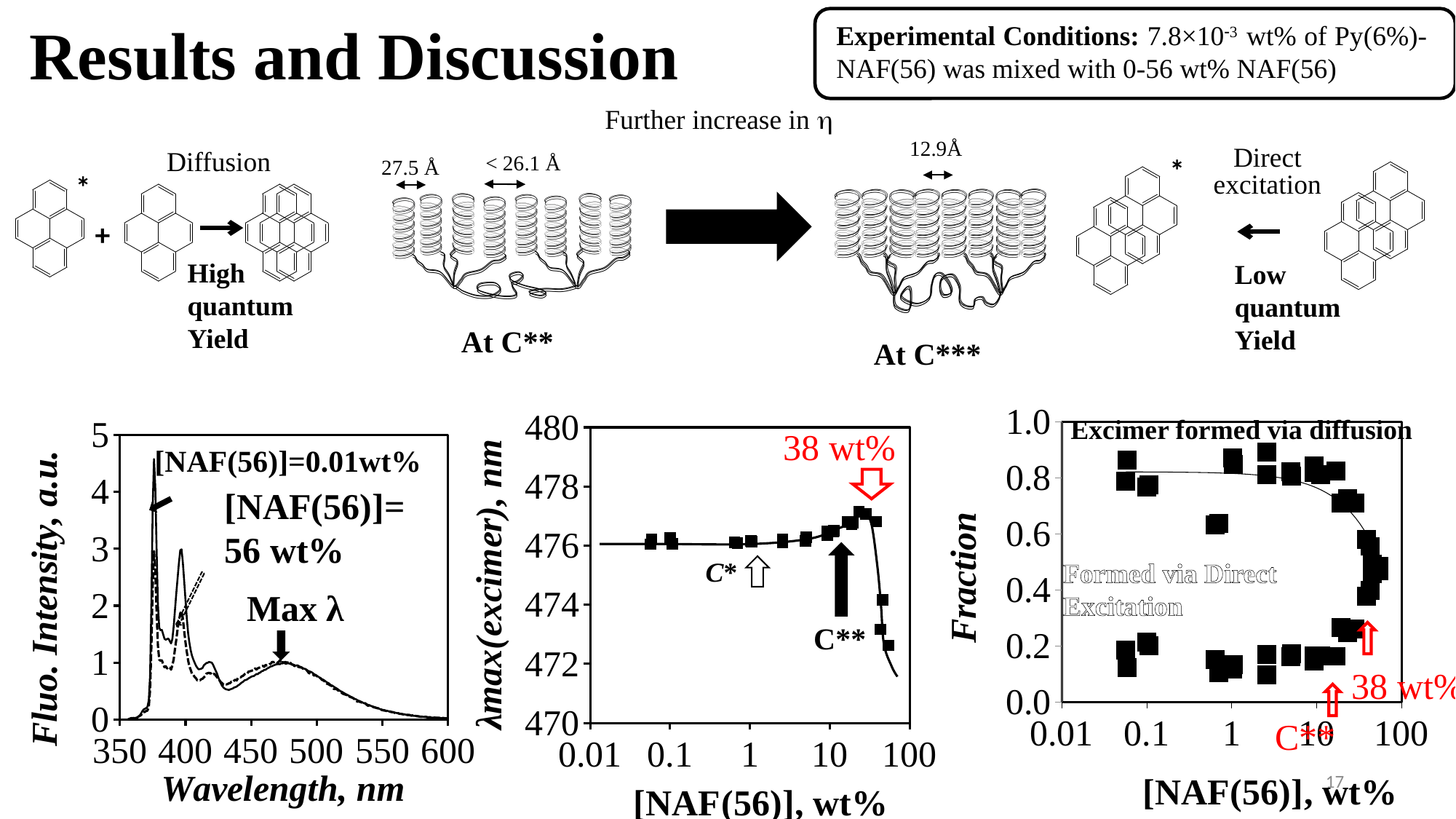
What is the y-axis label of the middle chart? λmax(excimer), nm In the right chart, is the fraction of excimer formed via diffusion at 1 wt% [NAF(56)] greater or less than 0.6? greater In the right chart (Fraction vs [NAF(56)]), which series has the larger fraction at 0.1 wt%: excimer formed via diffusion or formed via direct excitation? Excimer formed via diffusion In the left chart, is the highest fluorescence intensity peak greater or less than 4? greater In the left chart, how many [NAF(56)] concentrations are plotted as curves? 2 In the middle chart, is λmax(excimer) at 0.1 wt% [NAF(56)] greater or less than 475 nm? greater What is the x-axis label of the left chart? Wavelength, nm In the middle chart, at what [NAF(56)] concentration is the peak of λmax(excimer) annotated? 38 wt% What kind of chart is the left chart (Fluo. Intensity vs Wavelength)? line chart In the middle chart, does λmax(excimer) rise or fall after the 38 wt% point? fall